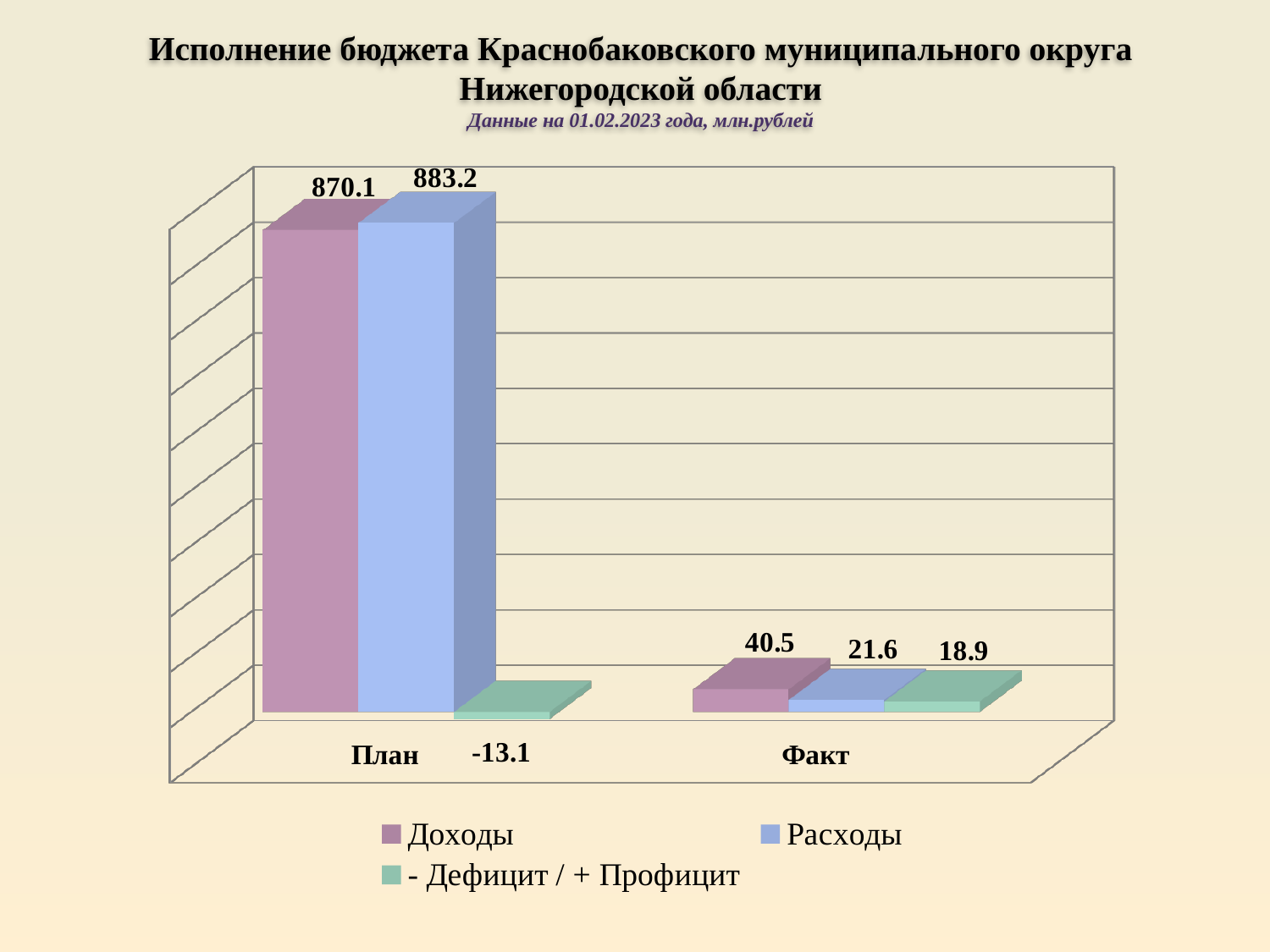
What is the difference between Расходы and Доходы for План? 13.1 What is the value of - Дефицит / + Профицит for Факт? 18.9 Which is larger for Факт: Доходы or Расходы? Доходы Which series has the highest value for План? Расходы Which series has the lowest value for Факт? - Дефицит / + Профицит What is the value of Расходы for План? 883.2 What is the value of - Дефицит / + Профицит for План? -13.1 What is the value of Доходы for Факт? 40.5 What is the value of Расходы for Факт? 21.6 How many series does the legend list? 3 What kind of chart is shown on the slide? Bar chart What is the value of Доходы for План? 870.1